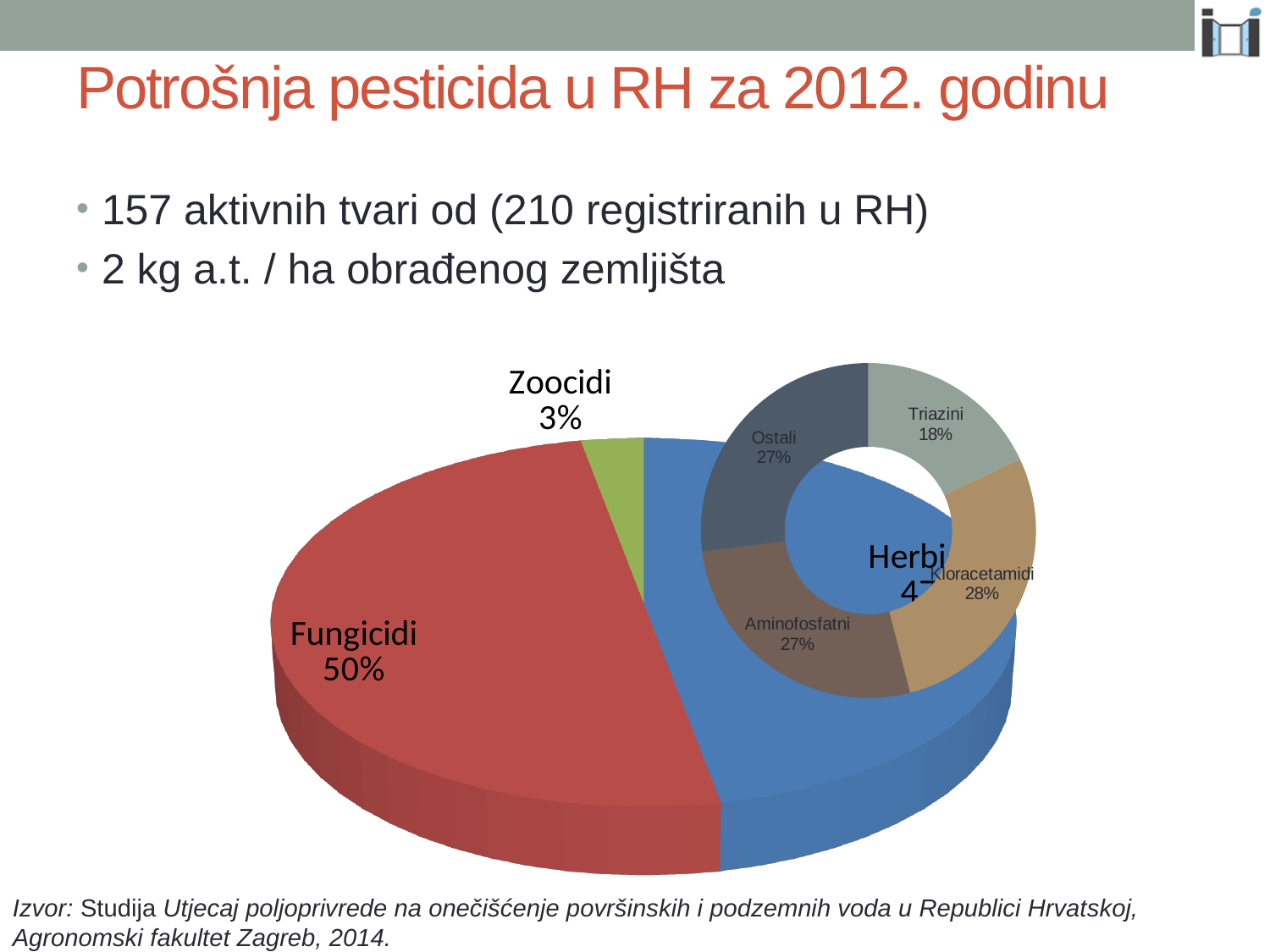
In the doughnut chart on the right, what share does Kloracetamidi have? 28% In the large pie chart, which category has the smallest slice? Zoocidi In the doughnut chart on the right, what share does Aminofosfatni have? 27% In the doughnut chart on the right, what share does Triazini have? 18% In the doughnut chart on the right, how many categories are shown? 4 In the doughnut chart on the right, which category has the smallest share? Triazini What kind of chart is the large chart on the left? Pie chart In the large pie chart, what share does Fungicidi have? 50% In the large pie chart, how many slices are there? 3 In the large pie chart, what is the difference between the Fungicidi and Zoocidi shares? 47% In the large pie chart, which category has the largest slice? Fungicidi In the large pie chart, what share does Zoocidi have? 3%